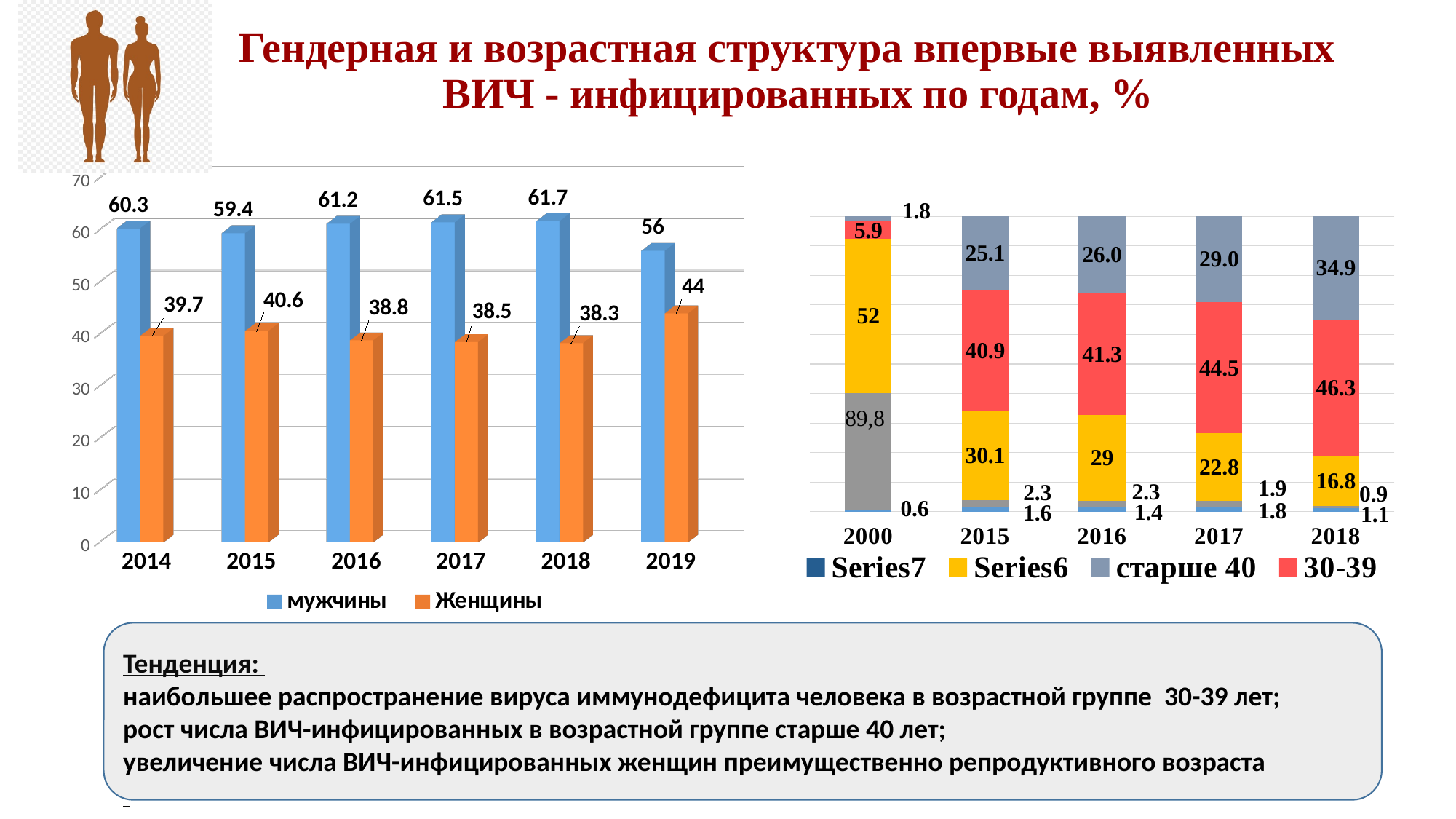
On the left chart, in which year is the value for мужчины lowest? 2019 On the left chart, how many years are shown on the x axis? 6 On the left chart, what is the difference between мужчины and Женщины in 2014? 20.6 On the right chart, what is the value for 30-39 in 2017? 44.5 On the right chart, what is the value for старше 40 in 2018? 34.9 On the left chart, what is the value for мужчины in 2018? 61.7 On the left chart, in which year is the value for Женщины highest? 2019 On the right chart, does the value for старше 40 rise or fall from 2015 to 2018? rise What kind of chart is the left chart? bar chart On the left chart, how many series does the legend list? 2 On the right chart, which is larger in 2016: 30-39 or старше 40? 30-39 On the left chart, what is the value for Женщины in 2019? 44